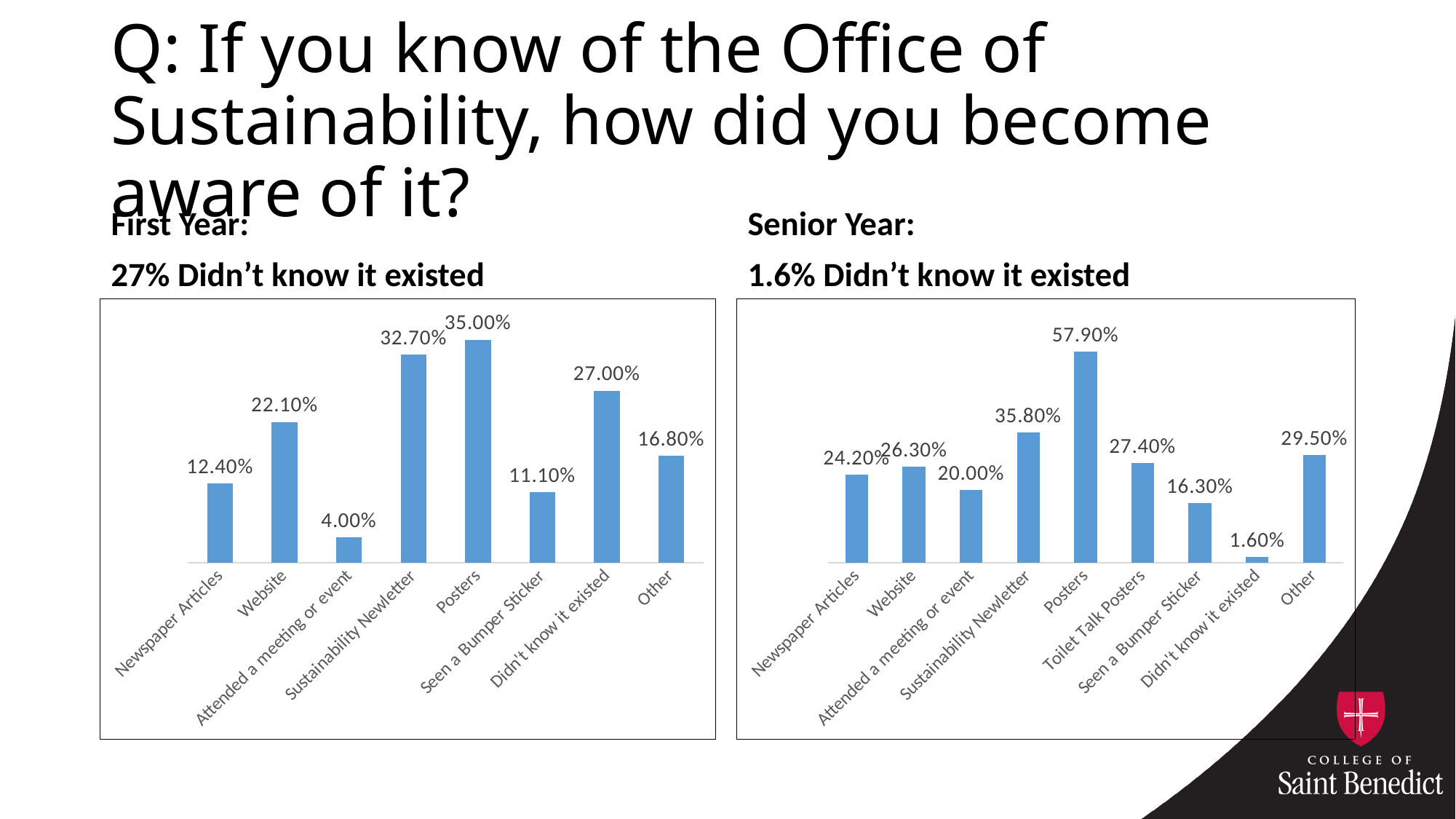
In the First Year chart, which category has the lowest value? Attended a meeting or event In the Senior Year chart, what is the value for Seen a Bumper Sticker? 16.30% How many categories are shown in the Senior Year chart? 9 In the First Year chart, what is the difference between the values for Posters and Website? 12.90% In the Senior Year chart, what is the value for Toilet Talk Posters? 27.40% In the Senior Year chart, which category has the highest value? Posters How many categories are shown in the First Year chart? 8 In the Senior Year chart, what is the difference between the values for Posters and Sustainability Newletter? 22.10% In the First Year chart, what is the value for Posters? 35.00% In the First Year chart, which is larger, the value for Didn't know it existed or the value for Other? Didn't know it existed What kind of chart is the First Year chart? Bar chart In the Senior Year chart, which category has the lowest value? Didn't know it existed